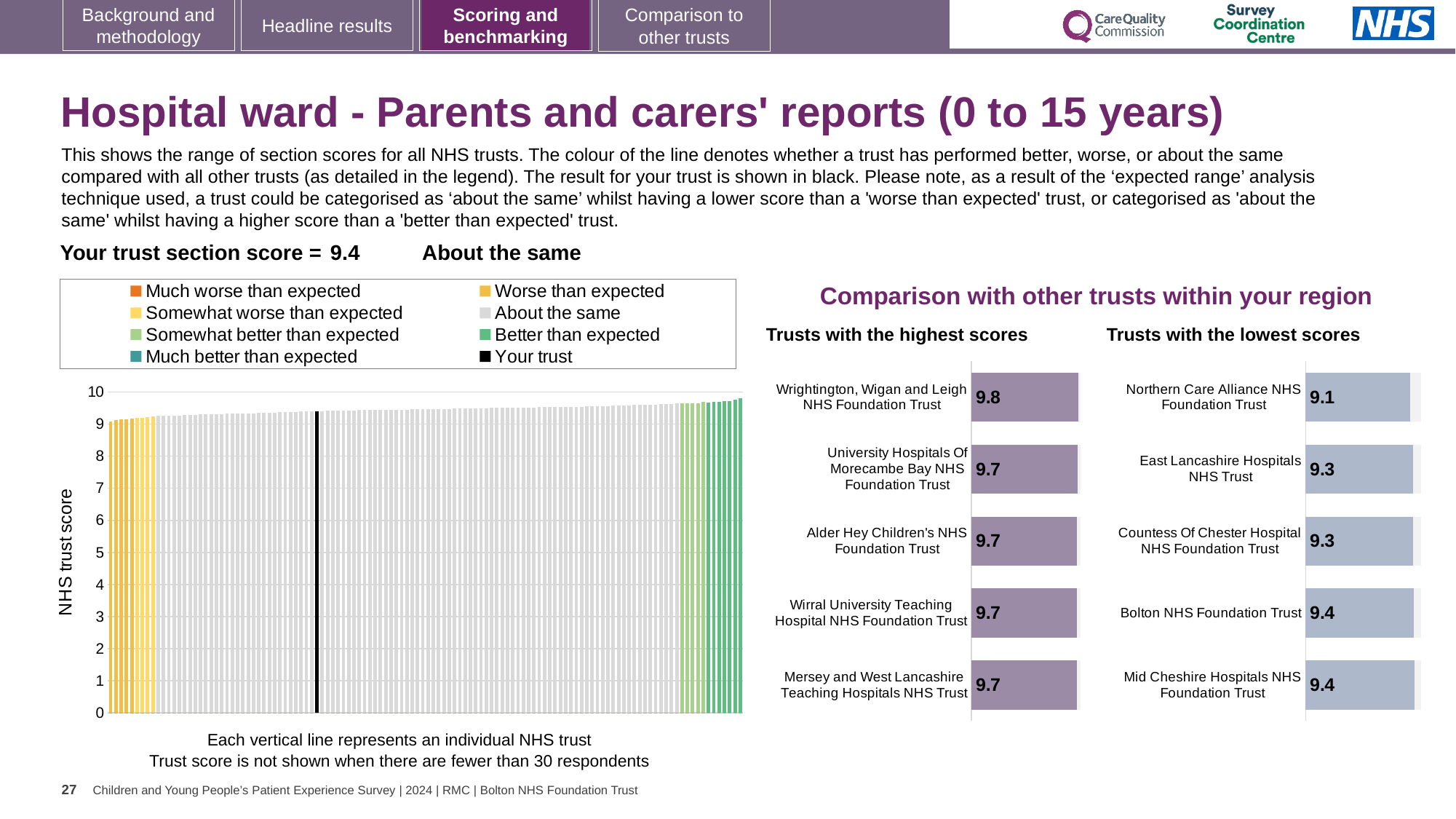
What kind of chart is the large chart on the left showing NHS trust scores? Bar chart In the 'Trusts with the lowest scores' chart, which trust has the lowest score? Northern Care Alliance NHS Foundation Trust In the left-hand NHS trust score chart, is the value for the black 'Your trust' bar greater or less than 5? greater In the 'Trusts with the lowest scores' chart, what is the score for Bolton NHS Foundation Trust? 9.4 How many trusts are shown in the 'Trusts with the highest scores' chart? 5 What is the difference between the score for Wrightington, Wigan and Leigh NHS Foundation Trust in the highest scores chart and the score for Northern Care Alliance NHS Foundation Trust in the lowest scores chart? 0.7 How many entries does the legend of the left-hand NHS trust score chart list? 8 In the 'Trusts with the highest scores' chart, what is the score for Wrightington, Wigan and Leigh NHS Foundation Trust? 9.8 In the 'Trusts with the lowest scores' chart, which has the larger score: East Lancashire Hospitals NHS Trust or Bolton NHS Foundation Trust? Bolton NHS Foundation Trust In the 'Trusts with the lowest scores' chart, what is the score for Northern Care Alliance NHS Foundation Trust? 9.1 What is the y-axis label of the left-hand chart? NHS trust score In the 'Trusts with the highest scores' chart, which trust has the highest score? Wrightington, Wigan and Leigh NHS Foundation Trust